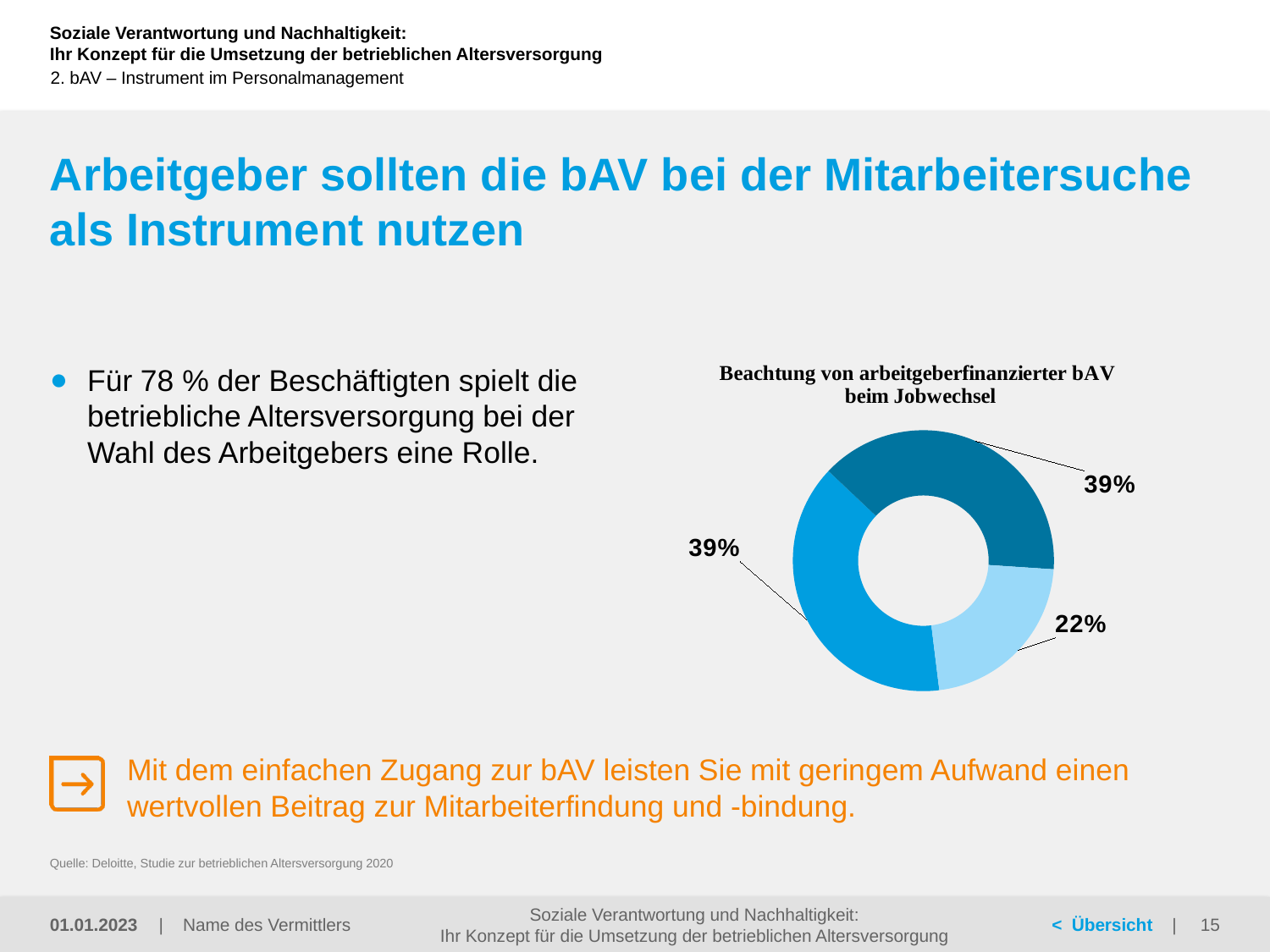
What is the value of the light blue slice at the bottom right of the chart? 22% What kind of chart is shown on the slide? Doughnut chart What is the sum of the three percentage labels shown on the chart? 100% Do the dark blue slice at the top right and the slice on the left have the same value? Yes, both 39% How many slices in the chart are labelled 39%? 2 Which is larger, the dark blue slice at the top right or the light blue slice at the bottom right? The dark blue slice at the top right What is the difference between the 39% slice and the 22% slice? 17% What is the title of the chart? Beachtung von arbeitgeberfinanzierter bAV beim Jobwechsel What is the value of the slice on the left side of the chart? 39% How many slices does the doughnut chart have? 3 What is the value of the smallest slice in the chart? 22% What is the value of the dark blue slice at the top right of the chart? 39%